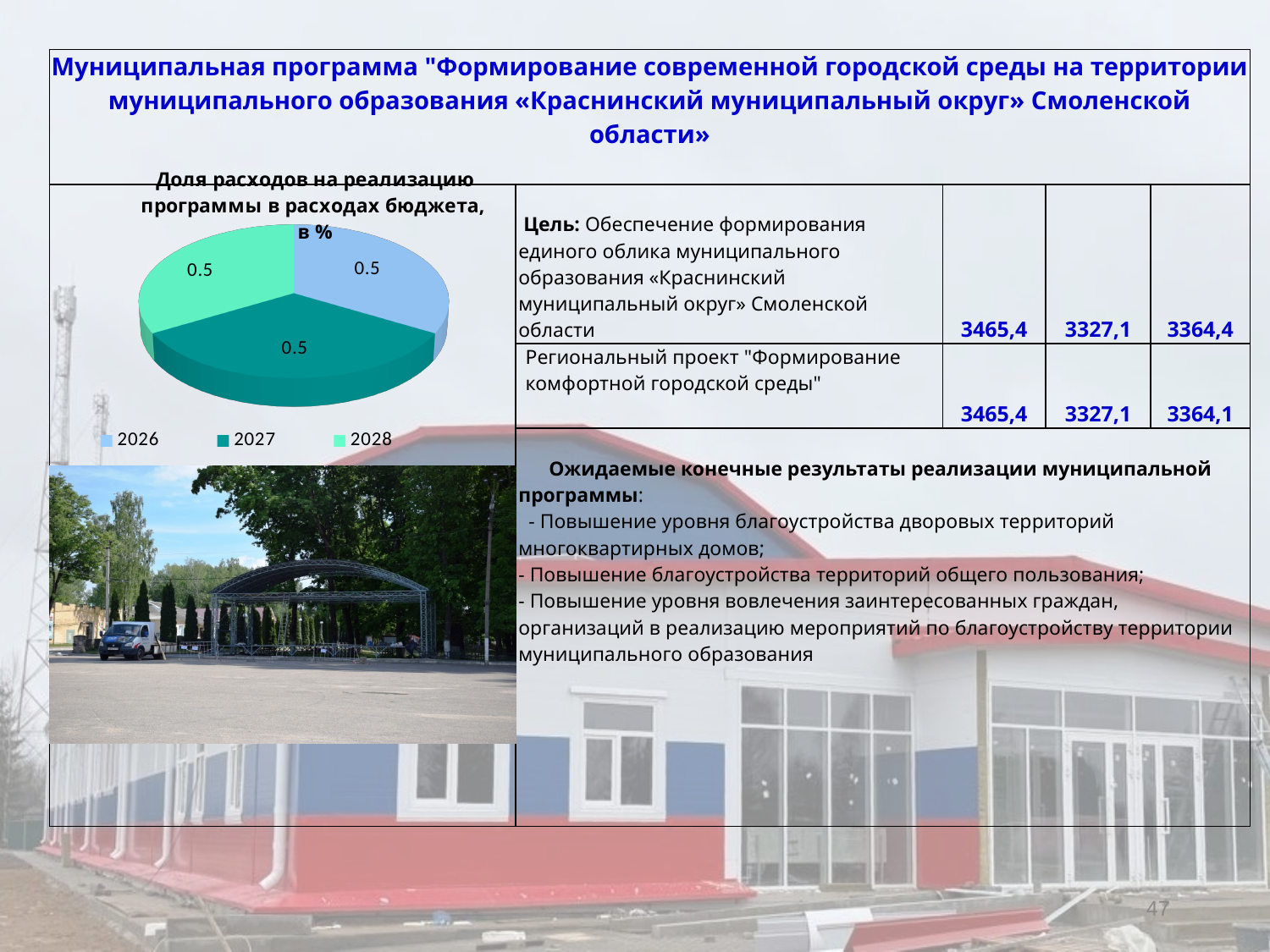
How many slices does the pie chart have? 3 Which years are listed in the legend of the pie chart? 2026, 2027, 2028 How many entries does the legend of the pie chart list? 3 What is the difference between the values for 2028 and 2026 in the pie chart? 0 What is the sum of the three values labelled on the pie chart? 1.5 What is the value shown for 2027 in the pie chart? 0.5 What kind of chart is shown on the slide? pie chart Is the value for 2026 larger than, smaller than, or equal to the value for 2027 in the pie chart? equal What is the title of the pie chart? Доля расходов на реализацию программы в расходах бюджета, в % What is the value shown for 2028 in the pie chart? 0.5 What is the value shown for 2026 in the pie chart? 0.5